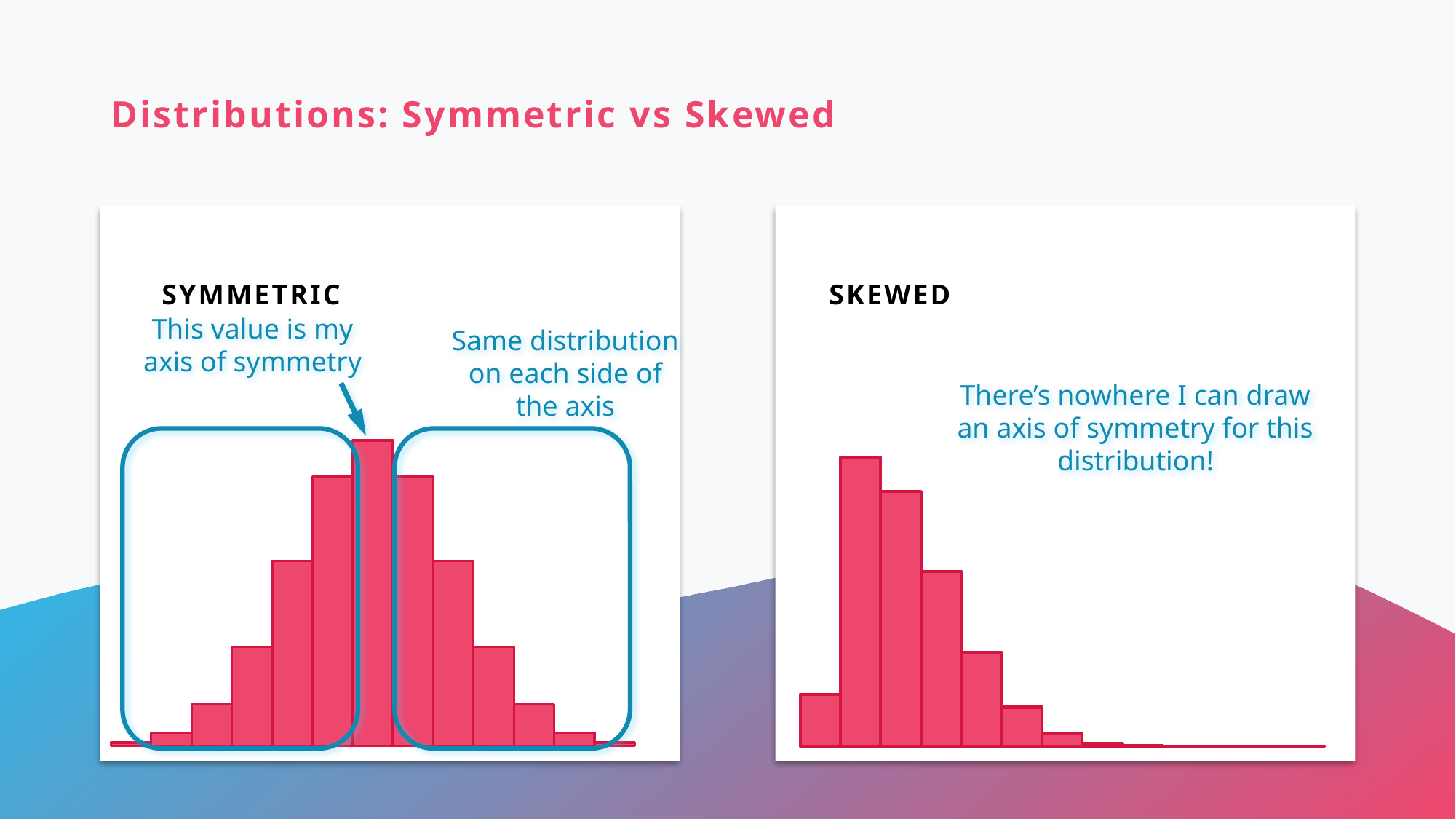
What is the title of the slide? Distributions: Symmetric vs Skewed In the SYMMETRIC chart on the left, do the bar heights rise or fall moving from the left edge toward the centre? Rise In the SKEWED chart on the right, do the bar heights rise or fall moving to the right after the peak? Fall In the SKEWED chart on the right, is the leftmost bar taller or shorter than the bar immediately to its right? Shorter In the SYMMETRIC chart on the left, which is taller: the bar immediately left of the centre bar or the bar at the far left edge? The bar immediately left of the centre bar In the SYMMETRIC chart on the left, which bar is the tallest? The centre bar In the SKEWED chart on the right, which is taller: the second bar from the left or the third bar from the left? The second bar from the left What kind of chart is shown in the SYMMETRIC panel on the left? Bar chart What colour are the bars in both charts? Pink/red In the SKEWED chart on the right, which bar is the tallest? The second bar from the left What kind of chart is shown in the SKEWED panel on the right? Bar chart